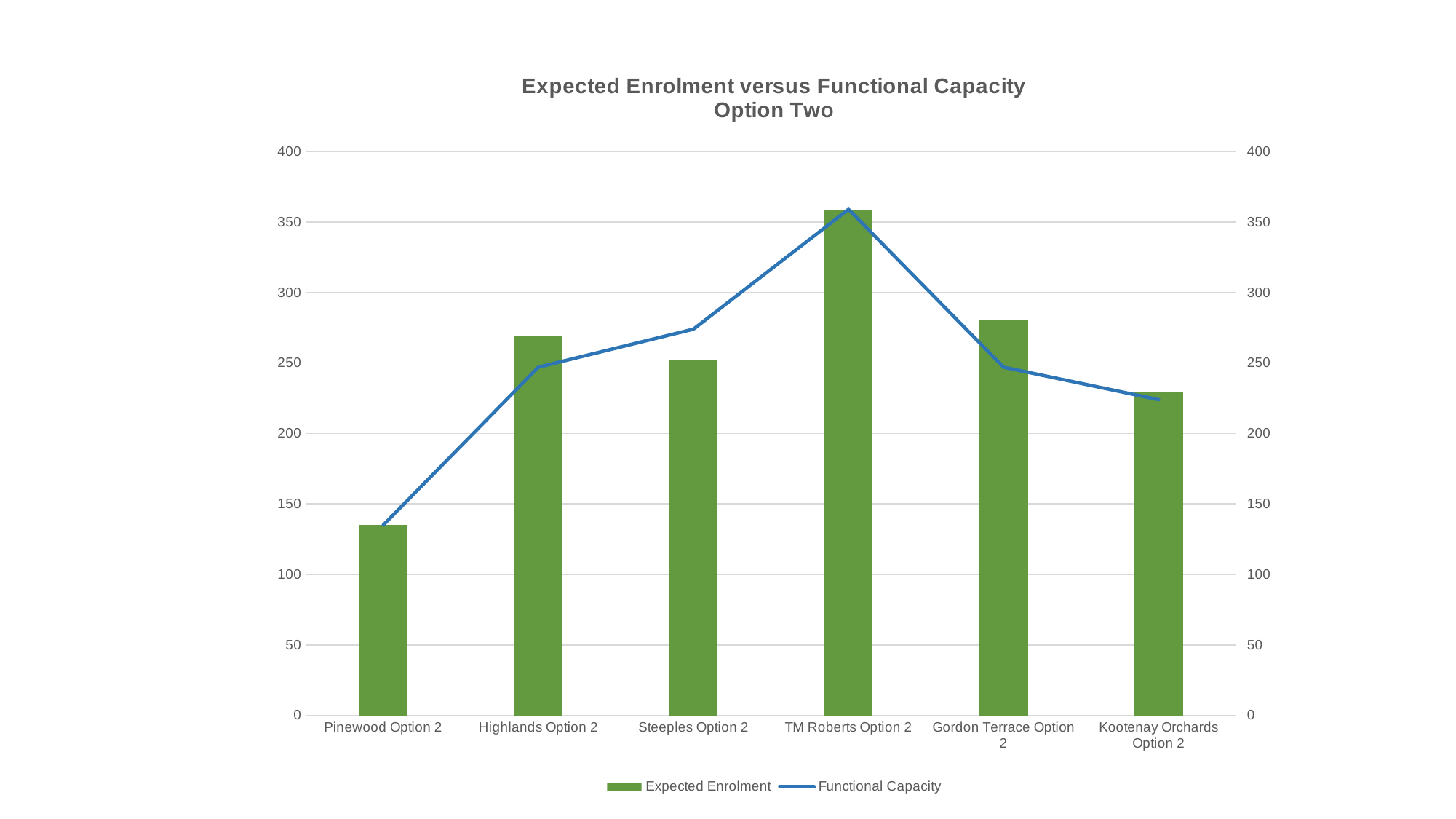
At which category does the Functional Capacity line reach its highest point? TM Roberts Option 2 How many series does the legend list? 2 For Steeples Option 2, which is larger: Expected Enrolment or Functional Capacity? Functional Capacity Which is larger, the Expected Enrolment for Highlands Option 2 or for Steeples Option 2? Highlands Option 2 How many categories are shown on the x axis? 6 Is the Expected Enrolment for Pinewood Option 2 greater or less than 150? less Is the Expected Enrolment for TM Roberts Option 2 greater or less than 350? greater Which category has the lowest Expected Enrolment bar? Pinewood Option 2 Is the Expected Enrolment for Kootenay Orchards Option 2 greater or less than 250? less Which category has the highest Expected Enrolment bar? TM Roberts Option 2 What is the title of the chart? Expected Enrolment versus Functional Capacity Option Two